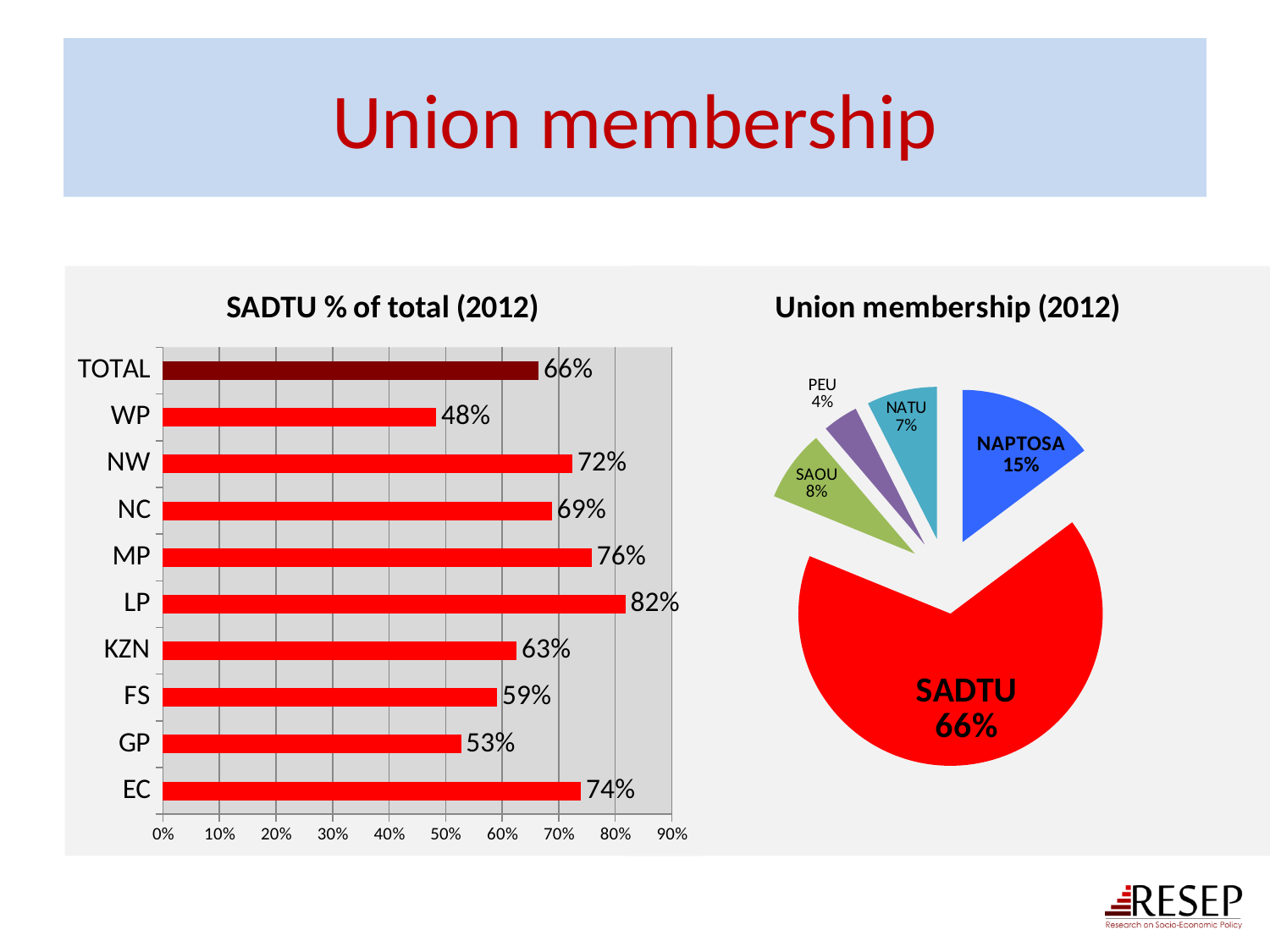
In the 'SADTU % of total (2012)' chart, what is the difference between the values for MP and GP? 23% In the 'Union membership (2012)' pie chart, how many slices are there? 5 In the 'Union membership (2012)' pie chart, which union has the smallest slice? PEU In the 'SADTU % of total (2012)' chart, what is the value for WP? 48% In the 'SADTU % of total (2012)' chart, which category has the lowest value? WP What kind of chart is 'SADTU % of total (2012)'? Bar chart In the 'SADTU % of total (2012)' chart, how many categories are shown on the vertical axis? 10 In the 'SADTU % of total (2012)' chart, which province has the highest value? LP In the 'SADTU % of total (2012)' chart, which is larger, the value for NC or the value for KZN? NC In the 'Union membership (2012)' pie chart, what share does SAOU have? 8% In the 'Union membership (2012)' pie chart, what share does NAPTOSA have? 15% In the 'SADTU % of total (2012)' chart, what is the value for LP? 82%